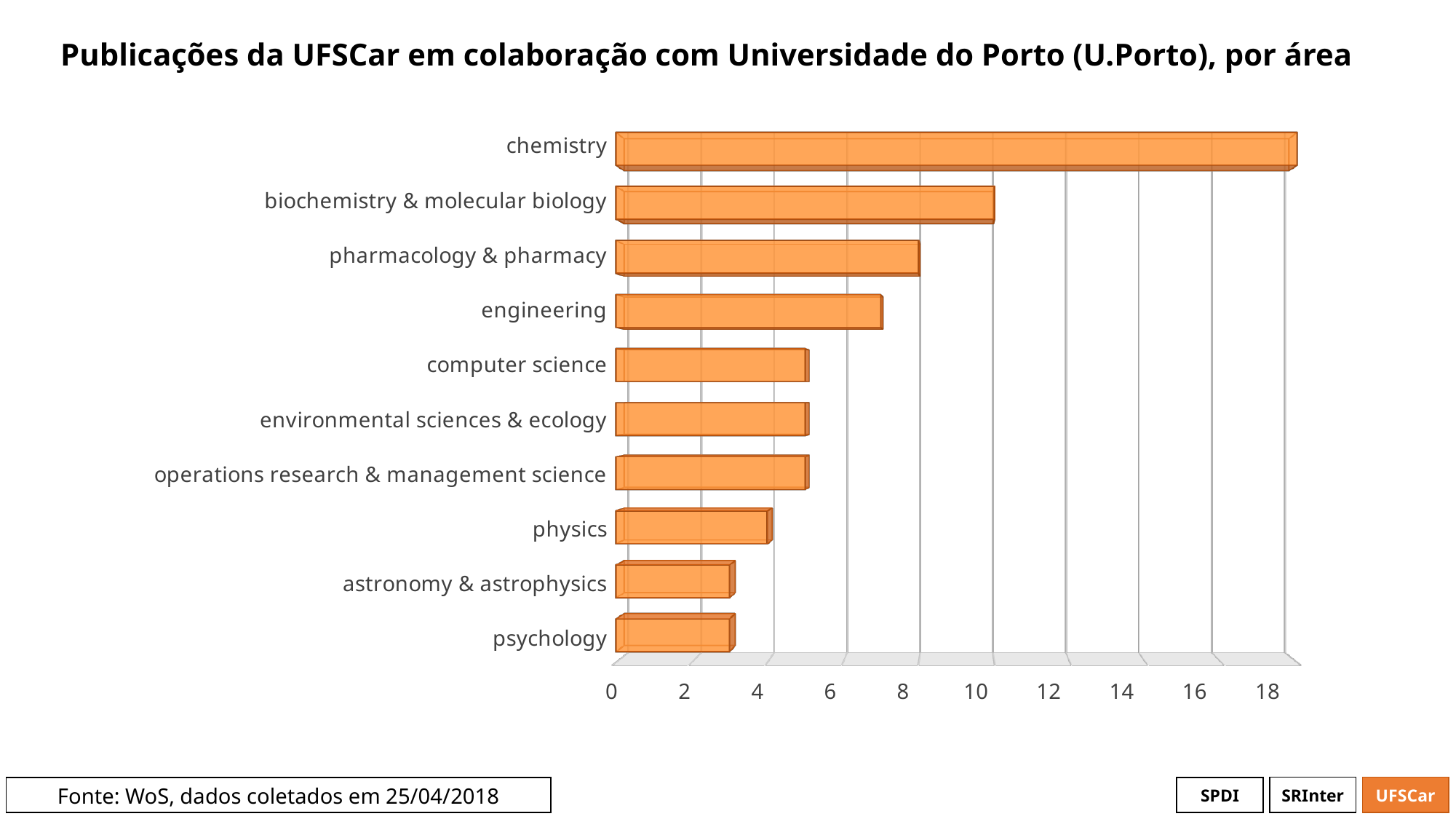
How many areas (categories) are shown in the chart? 10 Which area has the highest number of publications? chemistry Is the value for physics greater or less than 6? less Is the value for engineering greater or less than 6? greater Which has more publications, engineering or physics? engineering Is the value for pharmacology & pharmacy greater or less than 10? less What kind of chart is shown on the slide? bar chart What is the source of the data cited on the slide? WoS, dados coletados em 25/04/2018 Which has more publications, chemistry or biochemistry & molecular biology? chemistry